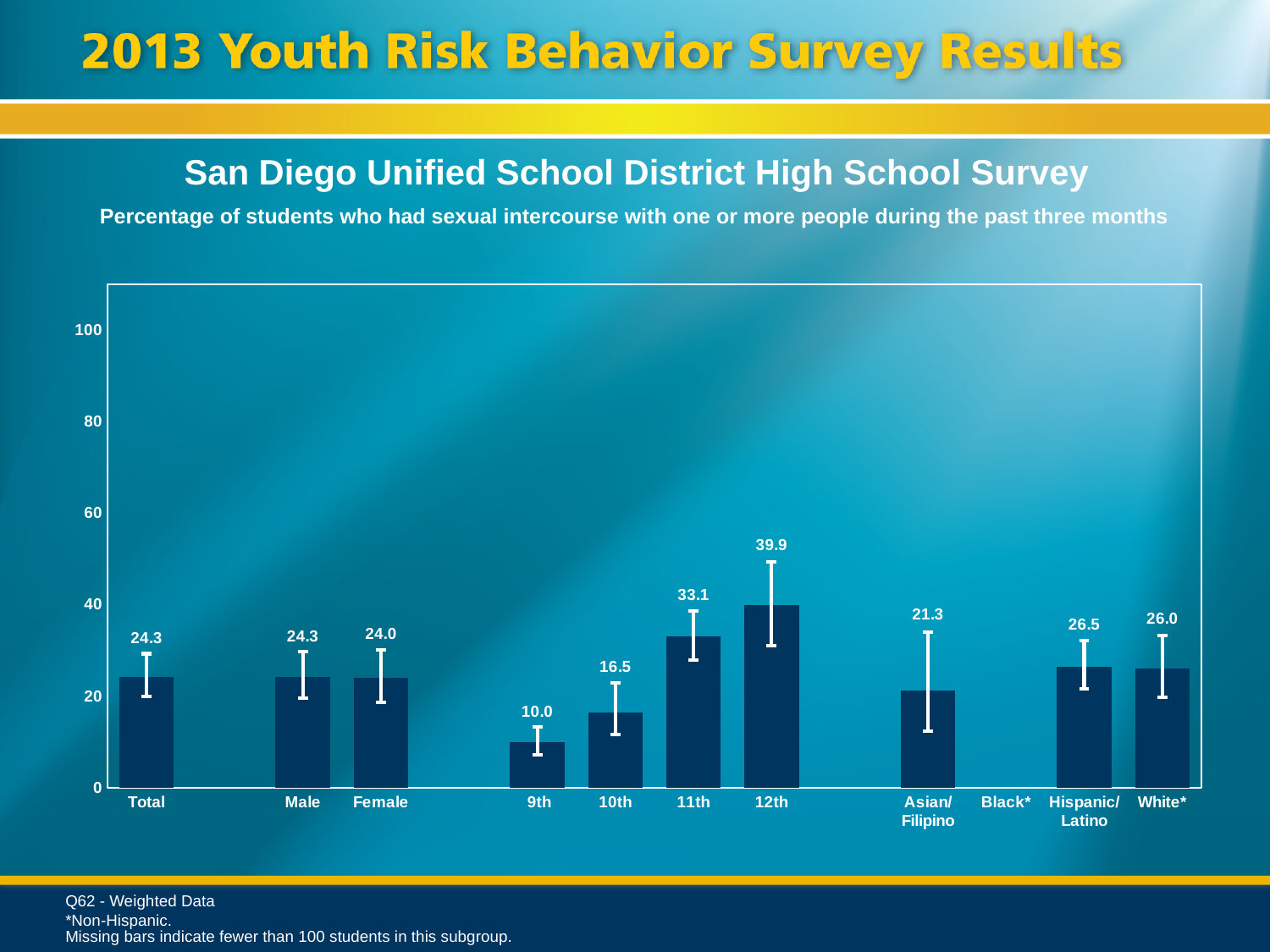
Do the values rise or fall from 9th grade to 12th grade? rise What kind of chart is shown on the slide? bar chart How many categories are labelled on the x axis? 11 Which category has the highest value? 12th What is the value for Asian/Filipino students? 21.3 Which category with a plotted bar has the lowest value? 9th What is the value for 12th grade students? 39.9 Is the value for 11th grade greater or less than 20? greater Which category has no bar plotted? Black* What is the difference between the values for 12th and 9th grade? 29.9 What is the value for the Total category? 24.3 Which is larger, the value for Hispanic/Latino or the value for White*? Hispanic/Latino